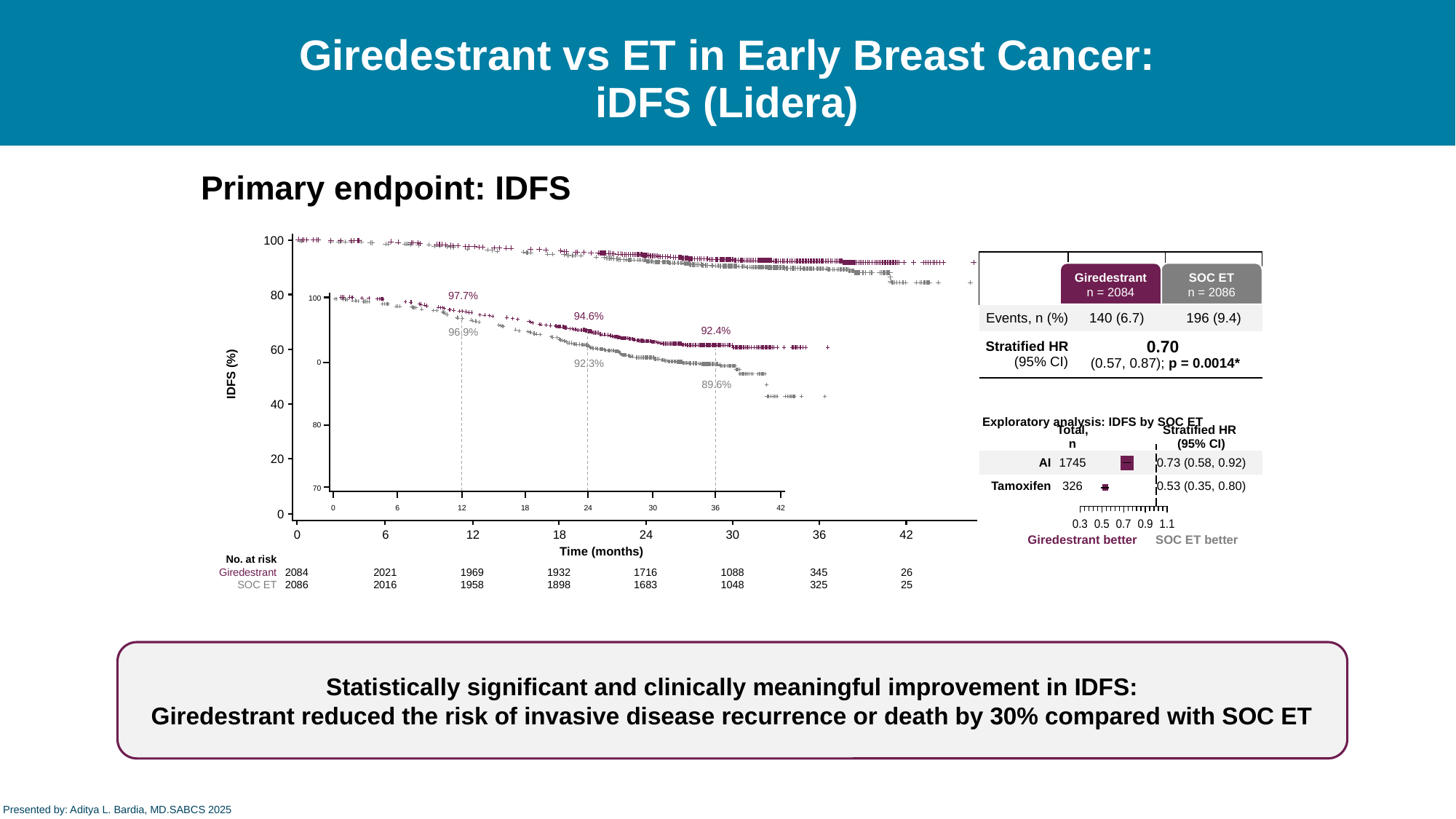
In the forest plot (Exploratory analysis: IDFS by SOC ET), what is the stratified HR (95% CI) for the Tamoxifen subgroup? 0.53 (0.35, 0.80) In the Kaplan-Meier chart, do the IDFS curves rise or fall as time increases? fall In the Kaplan-Meier chart, what is the IDFS rate for SOC ET at 36 months? 89.6% In the Kaplan-Meier chart, which arm has the higher IDFS rate at 36 months, Giredestrant or SOC ET? Giredestrant What kind of chart is the main plot on the left of the slide? Kaplan-Meier survival curve (line chart) In the Kaplan-Meier chart, what is the IDFS rate for Giredestrant at 12 months? 97.7% In the Kaplan-Meier chart, what is the difference between the Giredestrant and SOC ET IDFS rates at 24 months? 2.3 percentage points In the table on the right, how many events, n (%), occurred in the SOC ET arm? 196 (9.4) In the forest plot (Exploratory analysis: IDFS by SOC ET), how many subgroups are shown? 2 In the number-at-risk table below the Kaplan-Meier chart, how many Giredestrant patients were at risk at 18 months? 1932 In the table on the right, what is the stratified hazard ratio for Giredestrant vs SOC ET? 0.70 In the number-at-risk table below the Kaplan-Meier chart, how many SOC ET patients were at risk at 30 months? 1048